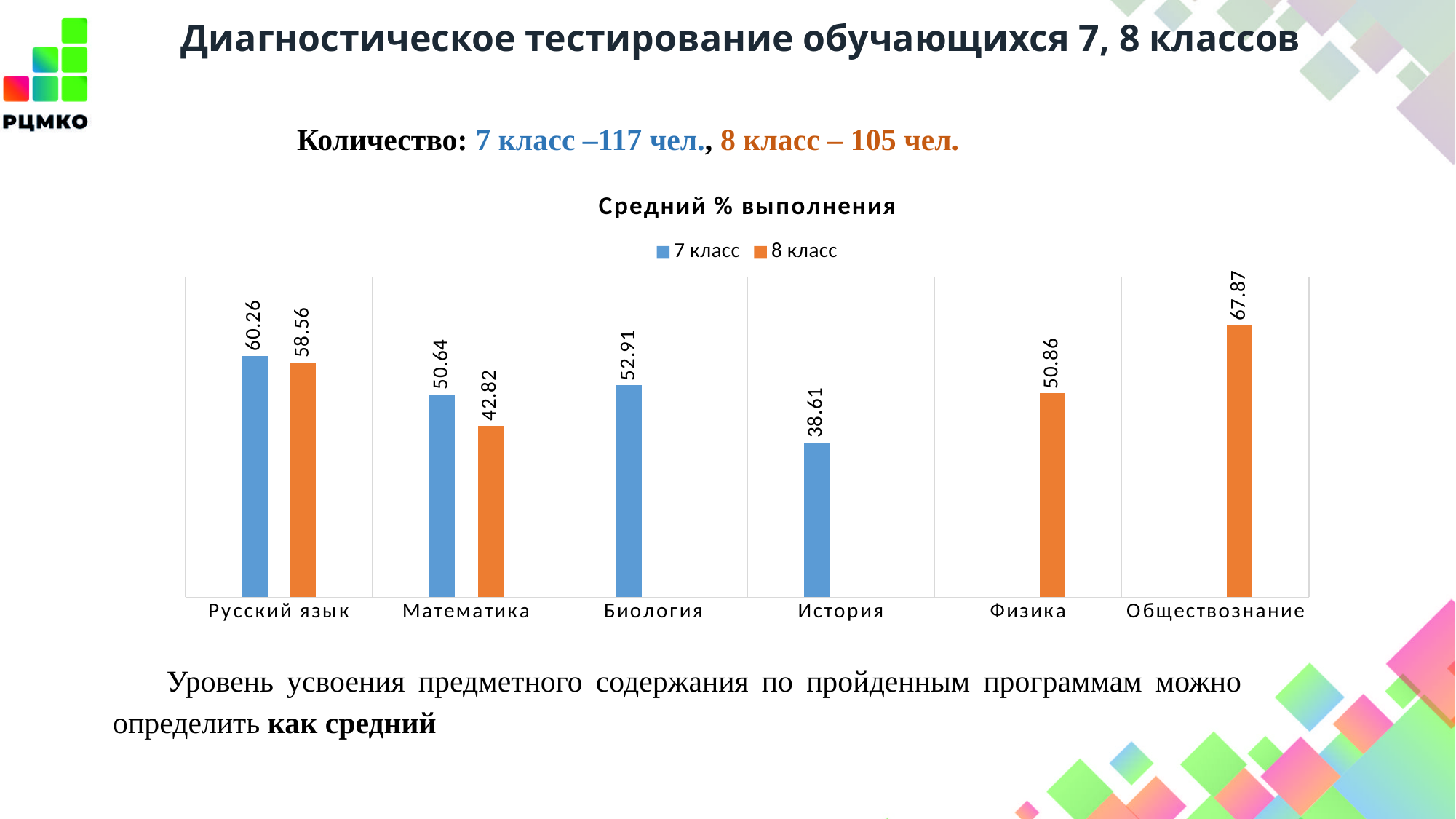
What is the value for 8 класс in Обществознание? 67.87 Which is larger in Русский язык: the 7 класс value or the 8 класс value? 7 класс What is the difference between the 7 класс and 8 класс values in Математика? 7.82 What is the value for 7 класс in Русский язык? 60.26 Which category has the lowest value for 7 класс? История How many categories are shown on the x axis? 6 What is the value for 8 класс in Математика? 42.82 Which category has the highest value for 8 класс? Обществознание What kind of chart is shown on the slide? bar chart What is the value for 7 класс in История? 38.61 What is the title of the chart? Средний % выполнения How many series does the legend list? 2